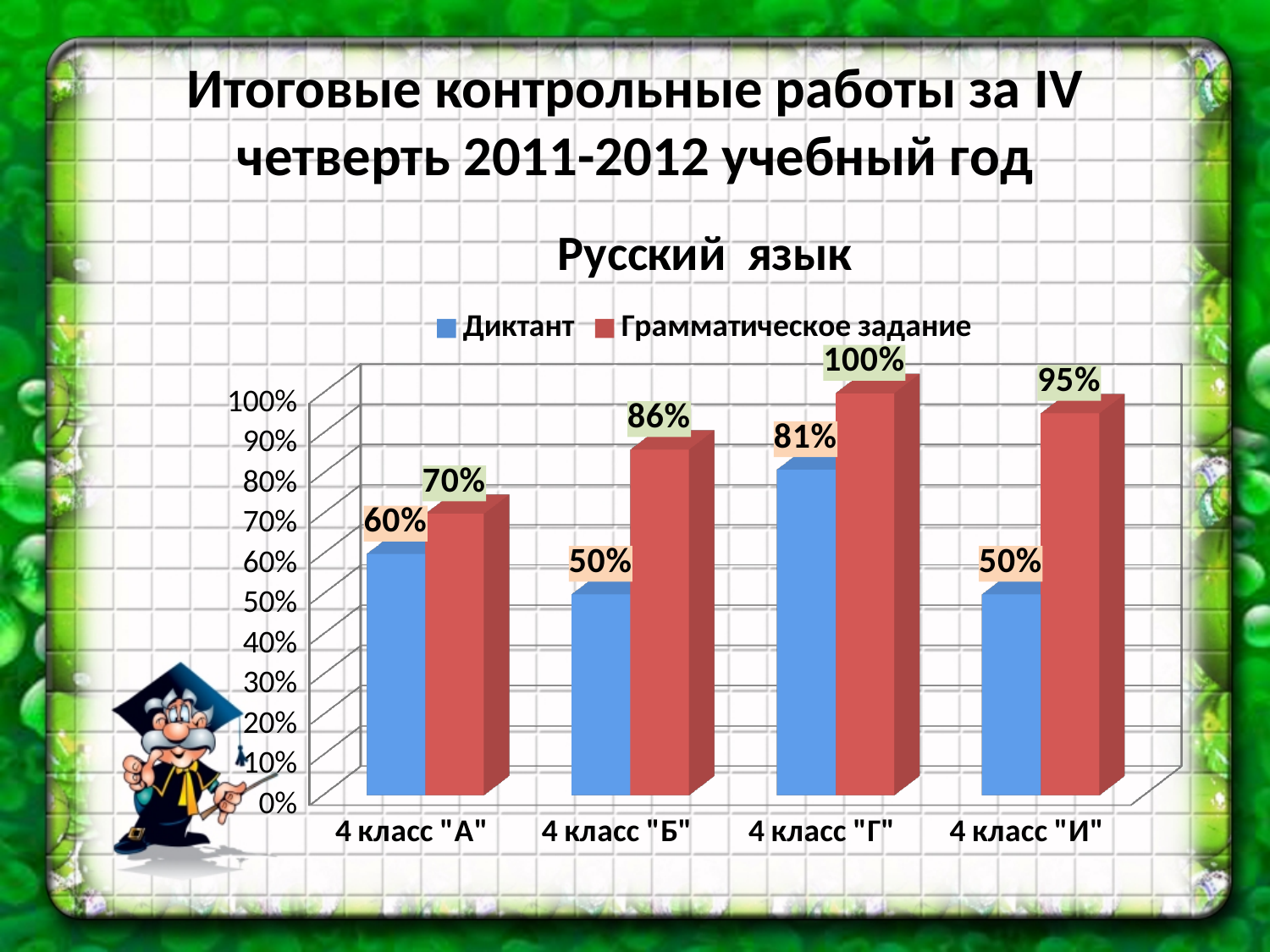
Which class has the highest Грамматическое задание value? 4 класс "Г" What kind of chart is shown? Bar chart How many classes are shown on the x axis? 4 Which class has the lowest Грамматическое задание value? 4 класс "А" What is the Диктант value for 4 класс "Г"? 81% What is the Диктант value for 4 класс "А"? 60% What is the difference between the Грамматическое задание and Диктант values for 4 класс "И"? 45% What is the Грамматическое задание value for 4 класс "Б"? 86% Which colour represents Диктант in the chart? Blue What is the title of the chart? Русский язык How many series does the legend list? 2 Which is larger: the Диктант value for 4 класс "Г" or the Диктант value for 4 класс "А"? 4 класс "Г"